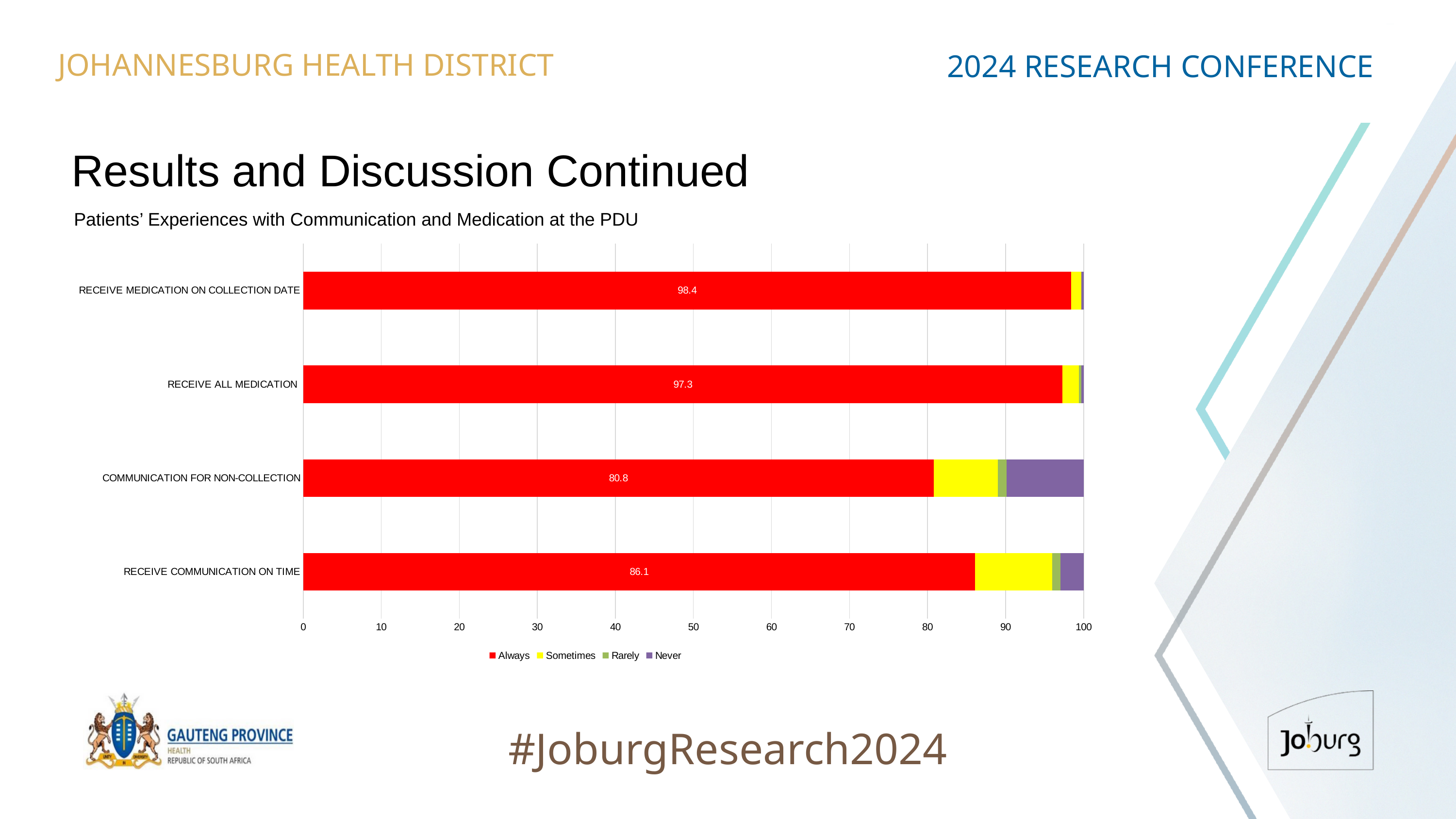
What is the Always value for Communication for non-collection? 80.8 What is the Always value for Receive all medication? 97.3 Is the Always value for Communication for non-collection greater or less than 90? less What is the Always value for Receive medication on collection date? 98.4 What is the difference between the Always values for Receive communication on time and Communication for non-collection? 5.3 How many series does the legend list? 4 Which category has the highest Always value? Receive medication on collection date What kind of chart is shown on the slide? Stacked bar chart How many categories are shown on the chart? 4 What is the Always value for Receive communication on time? 86.1 Which category has the lowest Always value? Communication for non-collection Which has a larger Always value: Receive all medication or Receive communication on time? Receive all medication